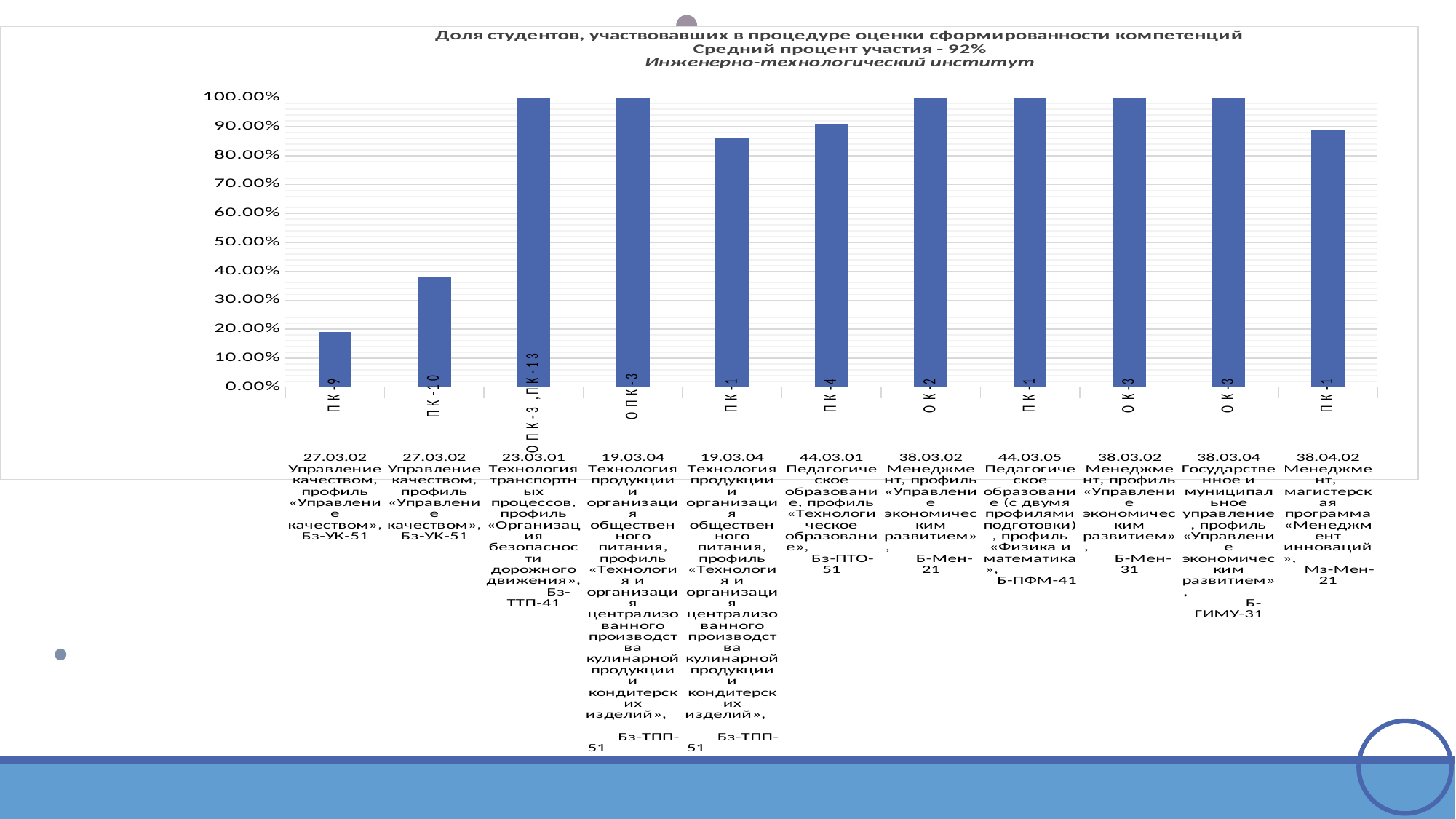
According to the chart title, what is the average participation percentage (Средний процент участия)? 92% What is the value for 44.03.05 Б-ПФМ-41 (ПК-1)? 100.00% What kind of chart is shown on the slide? bar chart Is the value for 44.03.01 Бз-ПТО-51 (ПК-4) greater or less than 80.00%? greater Is the value for 27.03.02 Бз-УК-51 (ПК-9) greater or less than 30.00%? less Which institute is named in the chart title? Инженерно-технологический институт Is the value for 27.03.02 Бз-УК-51 (ПК-10) greater or less than 50.00%? less How many bars (programme groups) are plotted in the chart? 11 Which group has the lowest share of students who participated? 27.03.02 Бз-УК-51 (ПК-9) Which is larger: the value for Бз-УК-51 (ПК-9) or the value for Бз-УК-51 (ПК-10)? Бз-УК-51 (ПК-10) What is the value for 23.03.01 Бз-ТТП-41 (ОПК-3, ПК-13)? 100.00%